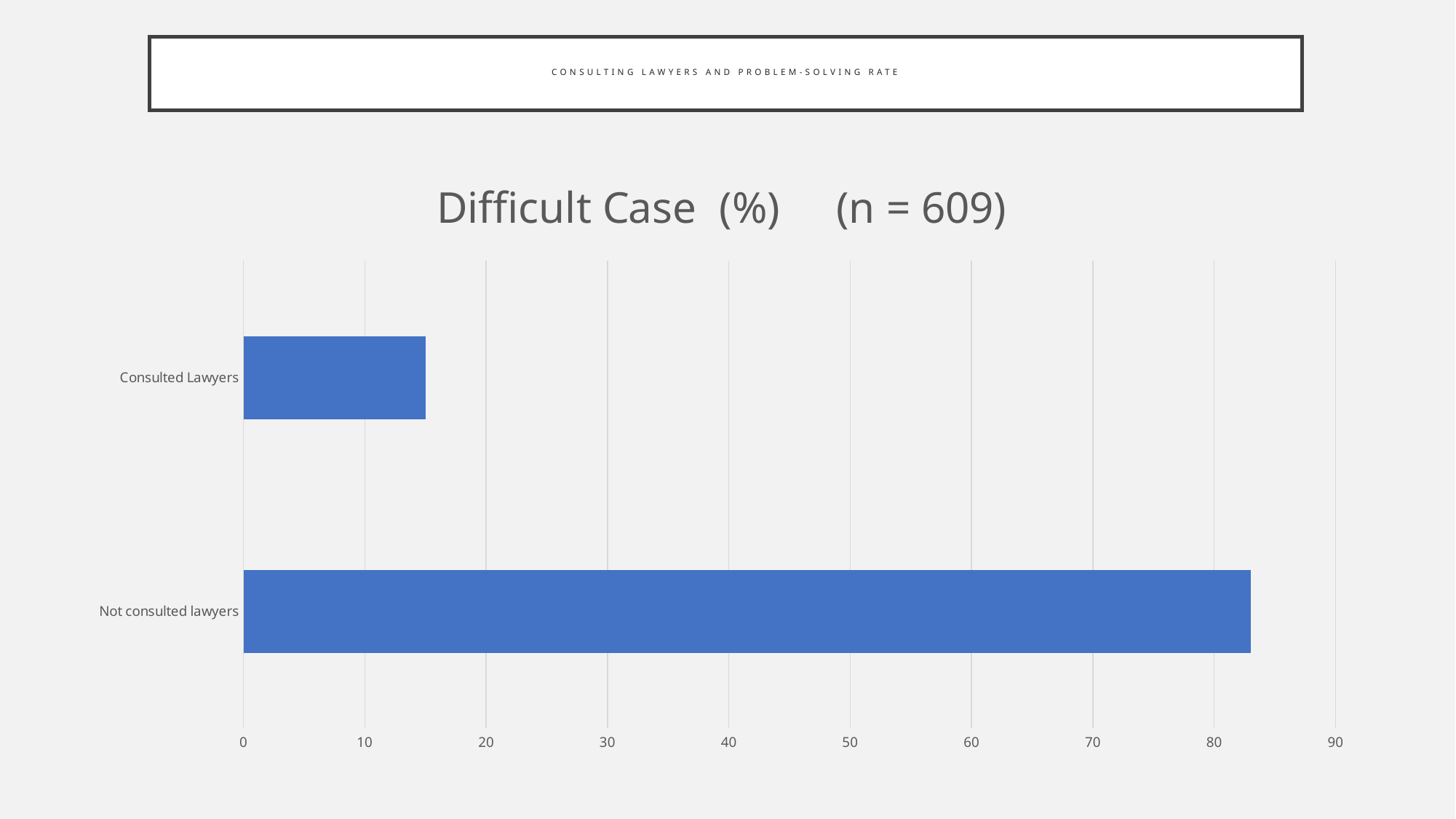
Is the value for Not consulted lawyers greater or less than 90? less Is the value for Not consulted lawyers greater or less than 80? greater Is the value for Consulted Lawyers greater or less than 10? greater How many categories are plotted in the chart? 2 What is the sample size (n) stated in the chart title? 609 What type of chart is shown on the slide? bar chart Which category has the highest value? Not consulted lawyers Which category has the lowest value? Consulted Lawyers Which is larger, the value for Consulted Lawyers or the value for Not consulted lawyers? Not consulted lawyers What is the title of the chart? Difficult Case (%) (n = 609)